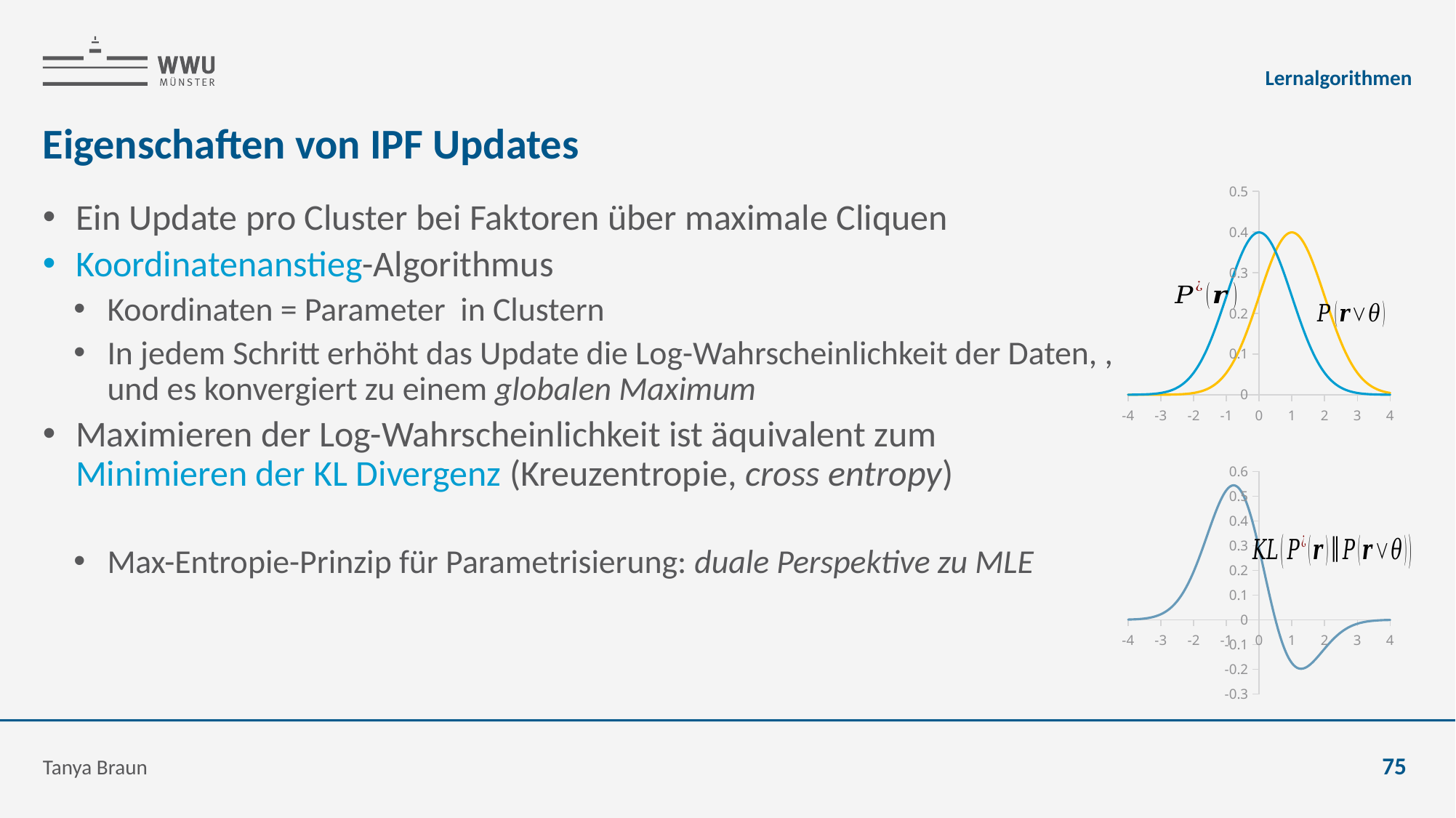
In the bottom chart, does the curve rise or fall between x = -1 and x = 1? fall In the bottom chart, is the value of the curve at x = -1 greater or less than 0.4? greater What is the highest tick value shown on the y axis of the top chart? 0.5 In the bottom chart, is the value of the curve at x = 1 greater or less than 0? less In the top chart, is the value of the blue curve at x = 0 greater or less than 0.3? greater How many curves are plotted in the top chart on the right? 2 How many curves are plotted in the bottom chart on the right? 1 In the top chart, does the blue curve rise or fall between x = -4 and x = 0? rise What kind of chart is the top chart on the right of the slide? line chart